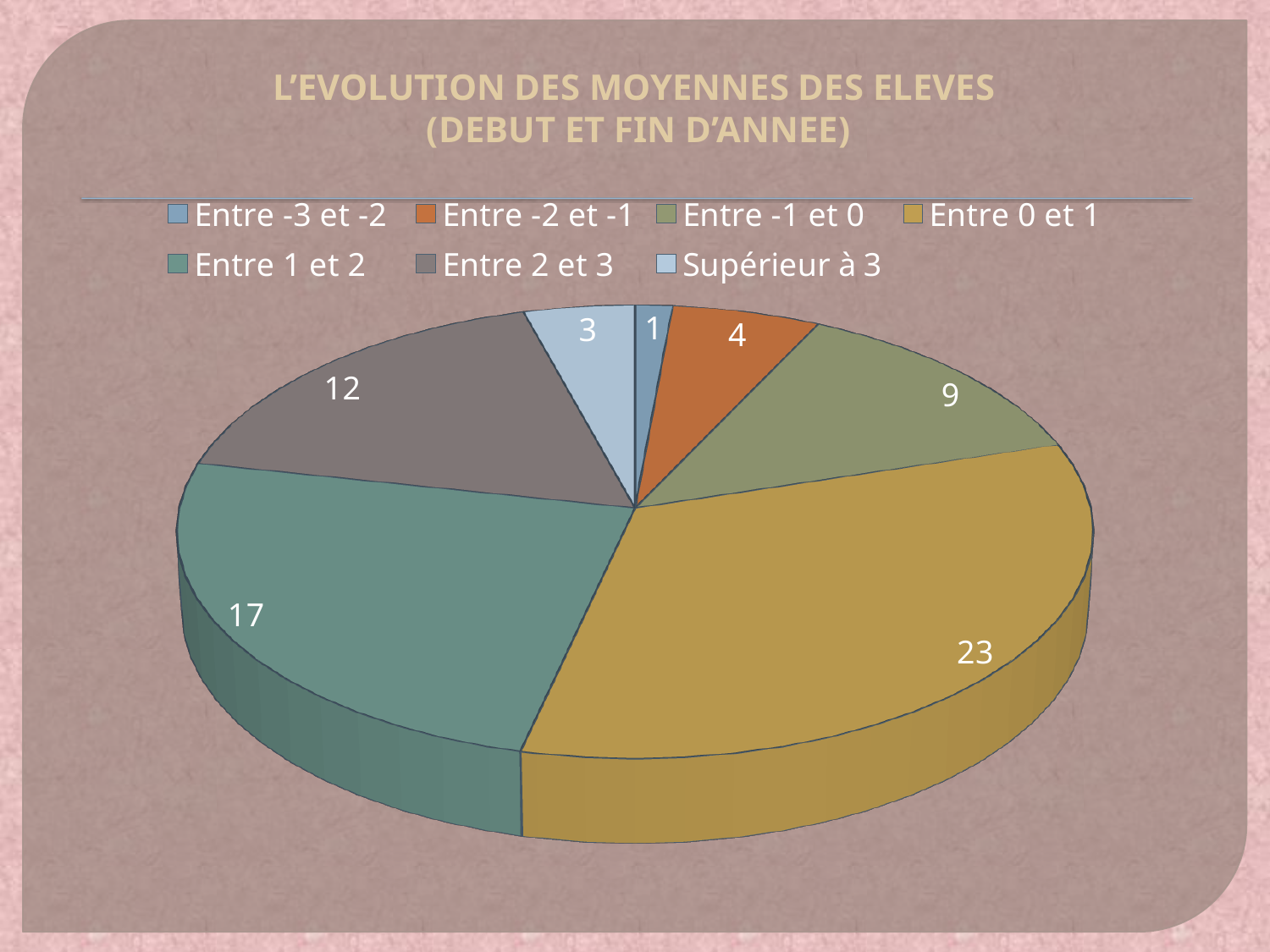
What is the difference between the values for 'Entre 0 et 1' and 'Entre 1 et 2'? 6 What is the value for the 'Entre 0 et 1' slice? 23 How many categories does the pie chart have? 7 What is the value for the 'Entre -1 et 0' slice? 9 Which is larger, the value for 'Entre 2 et 3' or the value for 'Entre -1 et 0'? Entre 2 et 3 What is the total of all the slice values in the pie chart? 69 Which category has the smallest slice of the pie? Entre -3 et -2 Which category has the largest slice of the pie? Entre 0 et 1 What is the value for the 'Supérieur à 3' slice? 3 What is the value for the 'Entre 1 et 2' slice? 17 What type of chart is shown on the slide? pie chart What is the title of the chart? L'EVOLUTION DES MOYENNES DES ELEVES (DEBUT ET FIN D'ANNEE)